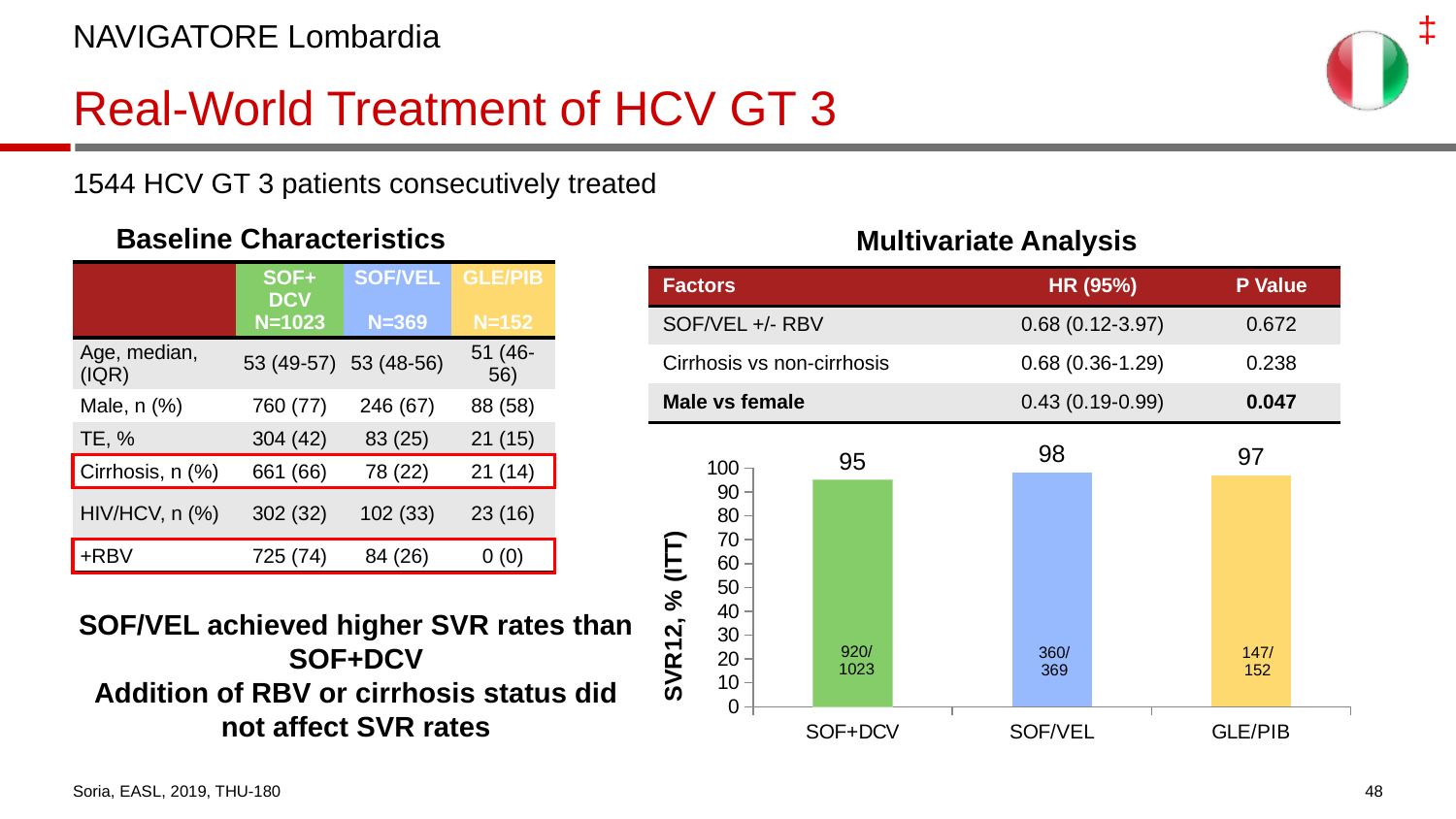
What is the SVR12 value for GLE/PIB in the bar chart? 97 What is the y-axis label of the bar chart? SVR12, % (ITT) What is the difference in SVR12 between SOF/VEL and SOF+DCV in the bar chart? 3 What is the SVR12 value for SOF/VEL in the bar chart? 98 Which treatment has the lowest SVR12 rate in the bar chart? SOF+DCV What is the SVR12 value for SOF+DCV in the bar chart? 95 What fraction is printed inside the SOF/VEL bar in the bar chart? 360/369 How many treatment categories are shown in the bar chart? 3 What is the difference in SVR12 between GLE/PIB and SOF+DCV in the bar chart? 2 What fraction is printed inside the GLE/PIB bar in the bar chart? 147/152 Which treatment has the highest SVR12 rate in the bar chart? SOF/VEL What type of chart is used to show SVR12 rates? Bar chart